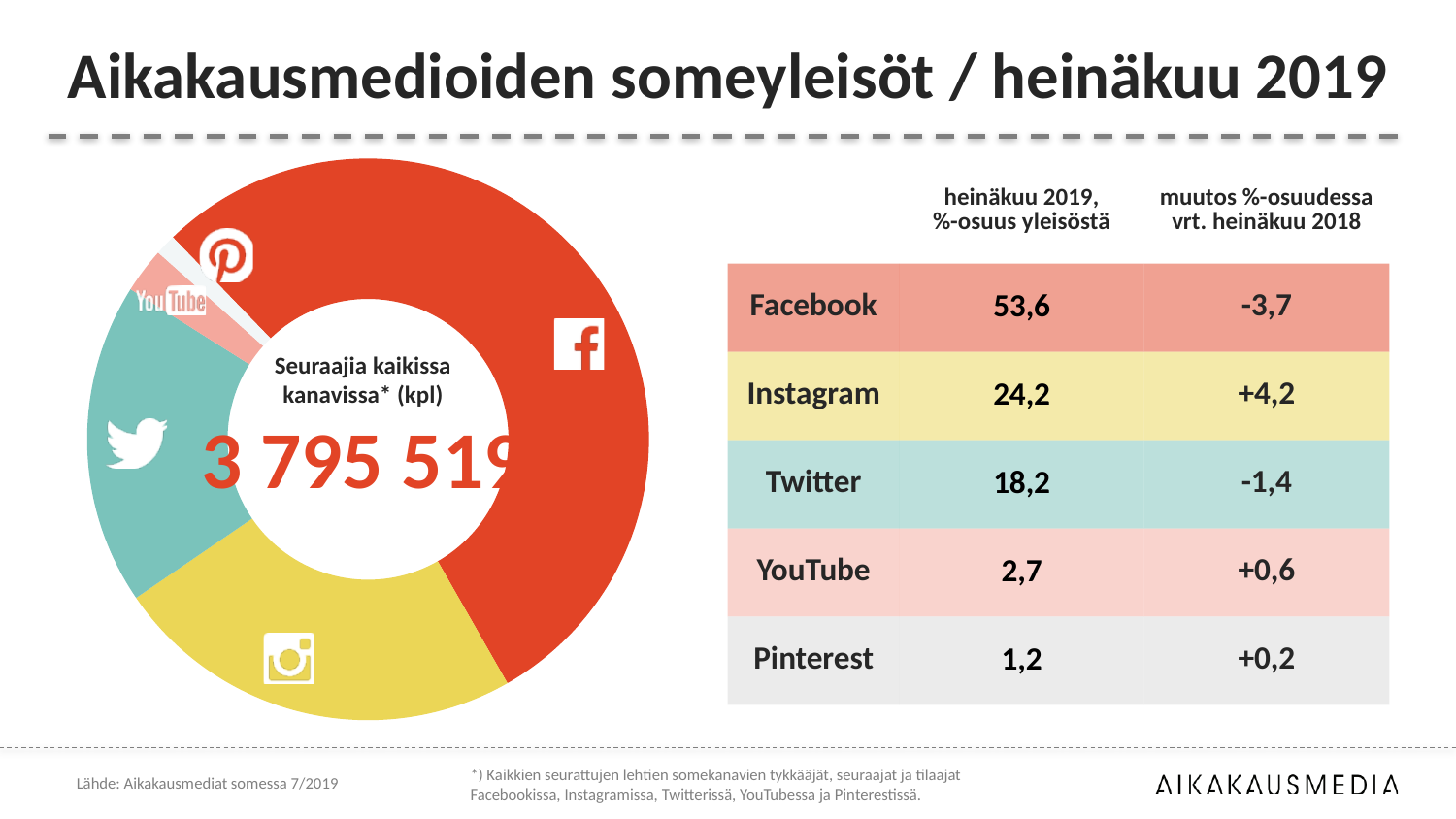
Which has a larger %-share of the audience, Twitter or YouTube? Twitter What is the total number of followers across all channels shown in the centre of the donut chart? 3 795 519 What is the change in %-share for Instagram compared to July 2018? +4,2 What kind of chart is shown on the left of the slide? Pie chart (donut) How many social media channels are shown as slices in the donut chart? 5 Which channel has the largest slice of the donut chart? Facebook What is Facebook's %-share of the audience in July 2019? 53,6 Which channel has the smallest slice of the donut chart? Pinterest What is the title of the slide? Aikakausmedioiden someyleisöt / heinäkuu 2019 What is the difference in %-share between Facebook and Instagram in July 2019? 29,4 What is the change in %-share for Twitter compared to July 2018? -1,4 What is Instagram's %-share of the audience in July 2019? 24,2